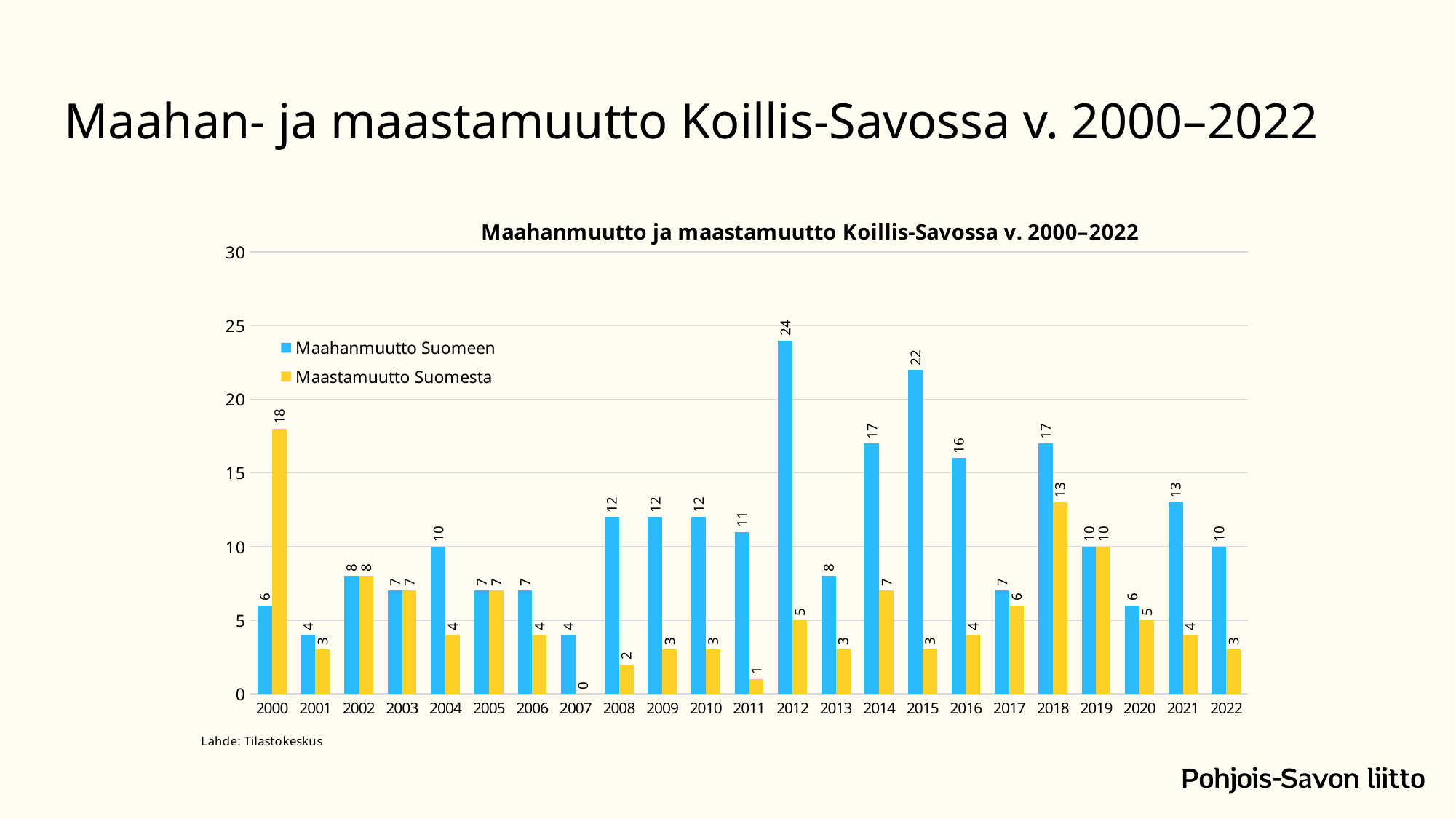
What is the value of Maastamuutto Suomesta in 2000? 18 What is the value of Maahanmuutto Suomeen in 2012? 24 How many years are shown on the x axis? 23 In which year is Maahanmuutto Suomeen highest? 2012 Which colour represents Maastamuutto Suomesta? Yellow What is the difference between Maahanmuutto Suomeen and Maastamuutto Suomesta in 2015? 19 In which year is Maastamuutto Suomesta lowest? 2007 Is the value of Maahanmuutto Suomeen in 2014 greater or less than 15? greater How many series does the legend list? 2 What kind of chart is shown on the slide? Bar chart What is the value of Maastamuutto Suomesta in 2018? 13 Which is larger in 2000, Maahanmuutto Suomeen or Maastamuutto Suomesta? Maastamuutto Suomesta